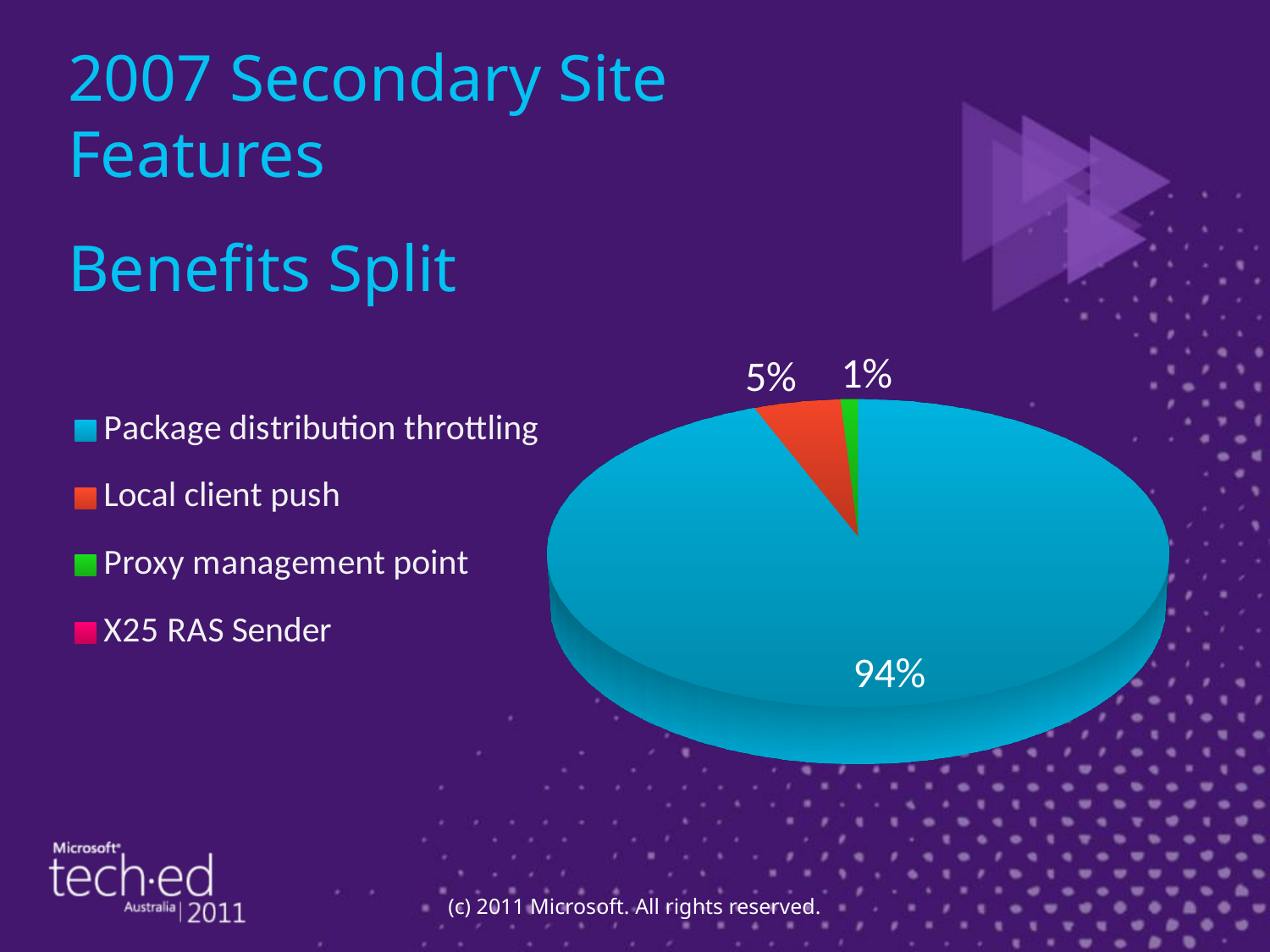
What is the difference in percentage points between the Local client push slice and the Proxy management point slice? 4 How many categories does the legend list? 4 What kind of chart is shown on the slide? pie chart Which category has the largest slice of the pie? Package distribution throttling Is the share for Package distribution throttling greater or less than 50%? greater Which legend entry is shown in green? Proxy management point Which is larger, the slice for Local client push or the slice for Proxy management point? Local client push What share of the pie does Proxy management point have? 1% What share of the pie does Package distribution throttling have? 94% What is the difference in percentage points between the Package distribution throttling slice and the Local client push slice? 89 What share of the pie does Local client push have? 5% What colour is the slice for Local client push? red